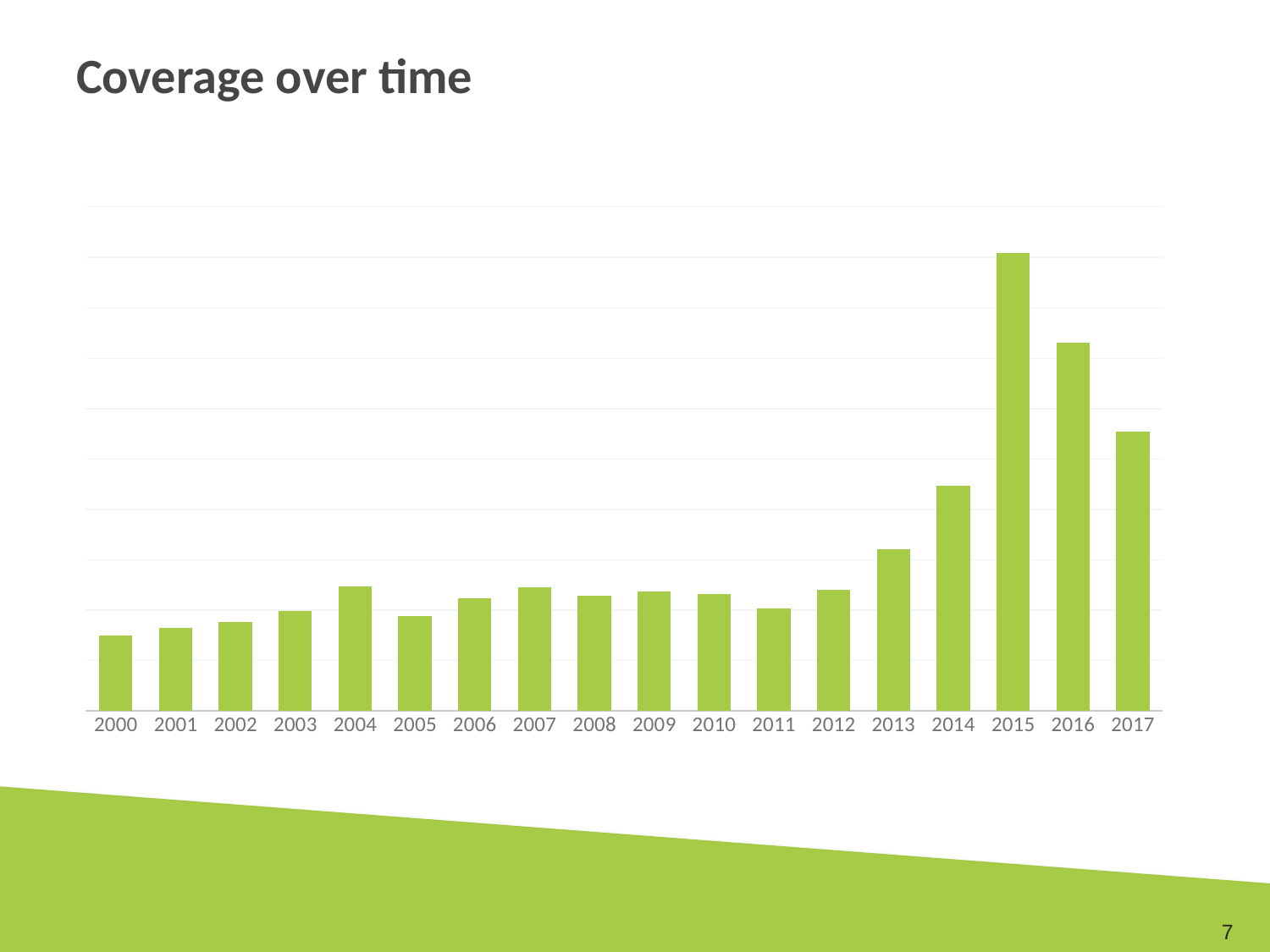
How many years are shown on the x axis of the chart? 18 What is the title of the chart? Coverage over time Do the values rise or fall from 2015 to 2017? Fall What colour are the bars in the chart? Green Which year has the larger value, 2011 or 2012? 2012 Which year has the larger value, 2013 or 2014? 2014 Which year has the lowest bar in the chart? 2000 What kind of chart is shown on the slide? Bar chart Which year has the larger value, 2004 or 2005? 2004 Do the values rise or fall from 2012 to 2015? Rise Which year has the highest bar in the chart? 2015